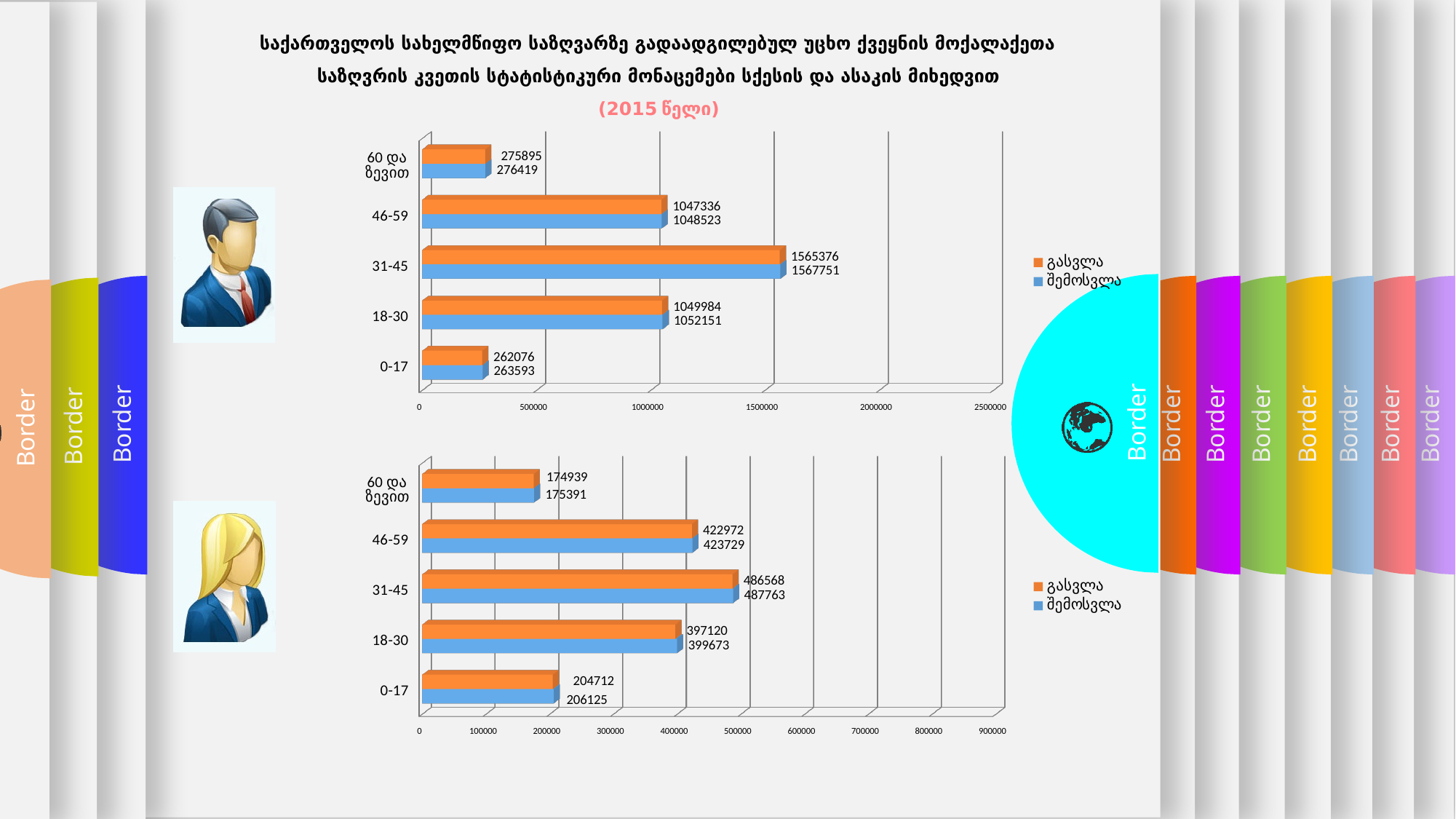
How many age groups are shown in the bottom chart? 5 What type of chart is the bottom chart? Bar chart In the bottom chart, which age group has the lowest გასვლა value? 60 და ზევით In the top chart, which age group has the highest შემოსვლა value? 31-45 In the top chart, what is the გასვლა value for the 31-45 age group? 1565376 In the top chart, which is larger: the გასვლა value for 46-59 or the გასვლა value for 18-30? 18-30 In the bottom chart, what is the შემოსვლა value for the 0-17 age group? 206125 In the top chart, what is the difference between the შემოსვლა and გასვლა values for the 31-45 age group? 2375 In the bottom chart, what is the difference between the შემოსვლა and გასვლა values for the 18-30 age group? 2553 In the top chart, what is the შემოსვლა value for the 18-30 age group? 1052151 How many series does the legend of the top chart list? 2 In the bottom chart, what is the გასვლა value for the 46-59 age group? 422972